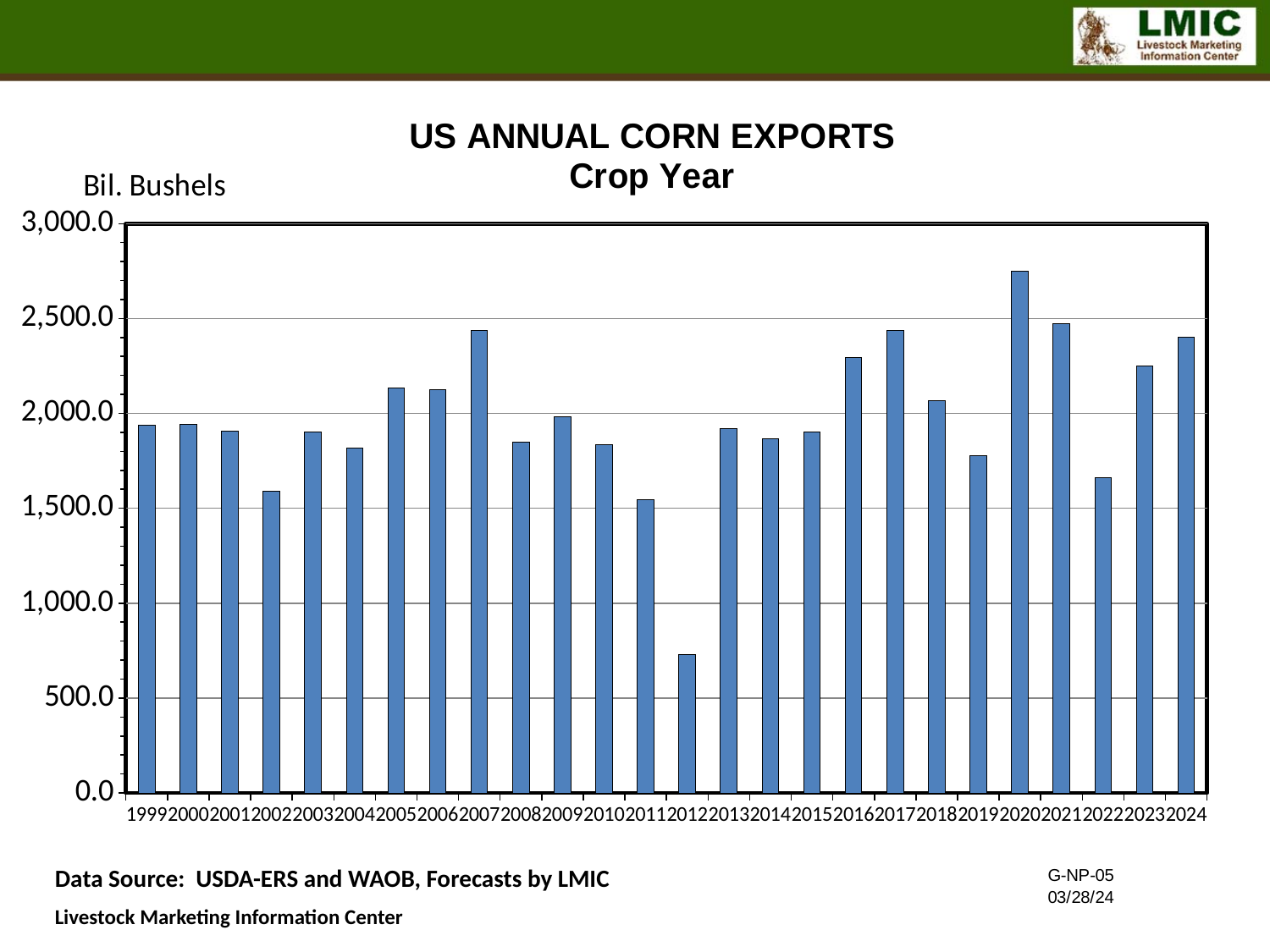
Is the value for 2019 greater or less than 2,000.0? less How many crop years are plotted on the chart? 26 What kind of chart is shown on the slide? bar chart Which crop year has the highest US annual corn exports? 2020 Do corn exports rise or fall from 2010 to 2012? fall Which crop year has larger corn exports, 2022 or 2023? 2023 Is the value for 2020 greater or less than 2,500.0? greater Which crop year has larger corn exports, 2020 or 2021? 2020 Which crop year has the lowest US annual corn exports? 2012 Is the value for 2016 greater or less than 2,000.0? greater What unit is shown on the vertical axis of the chart? Bil. Bushels